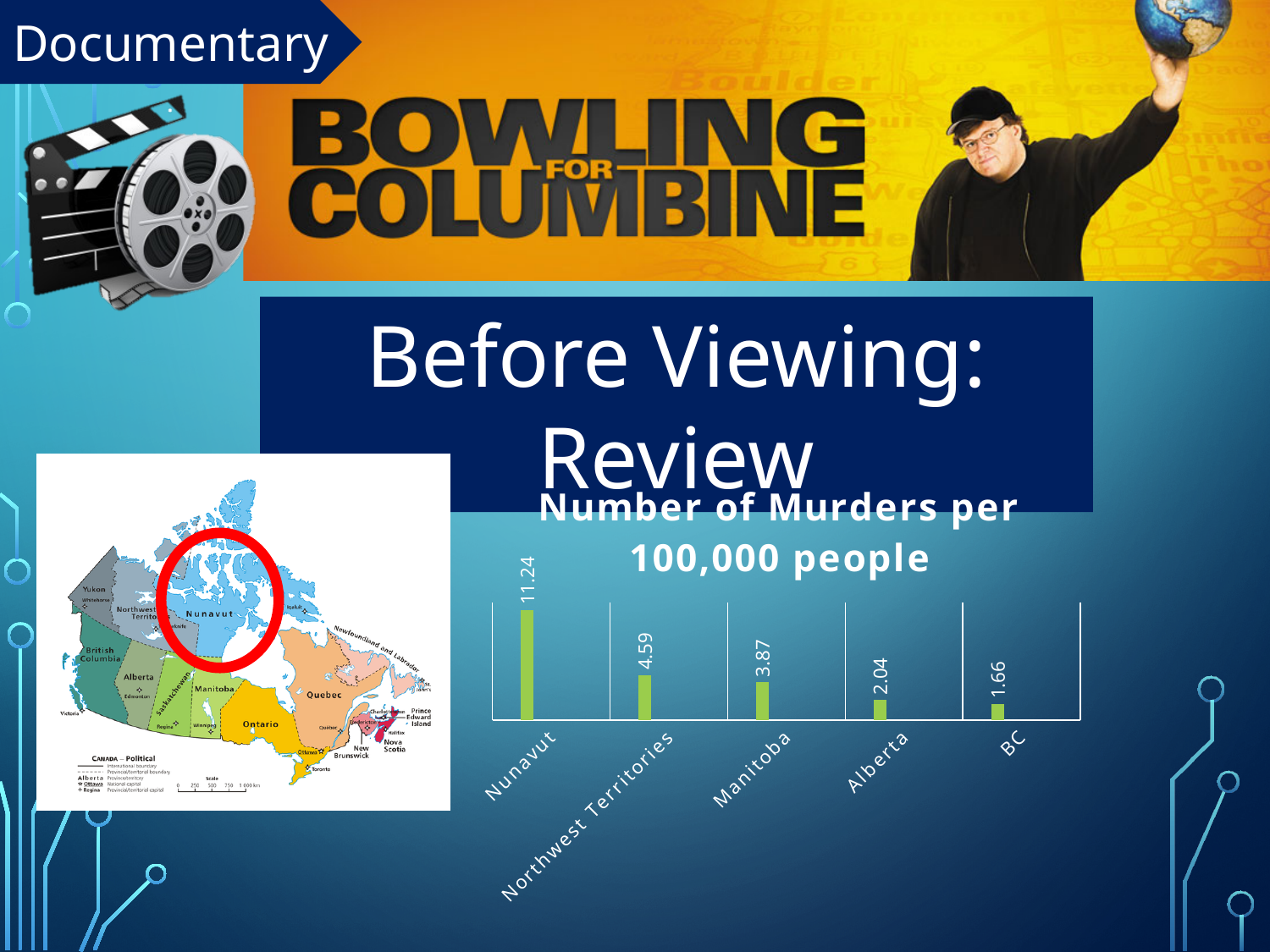
Which has a higher value, Manitoba or Alberta? Manitoba What kind of chart is shown on the slide? Bar chart What is the number of murders per 100,000 people for Alberta? 2.04 How many categories are shown in the chart? 5 What is the difference between the values for Alberta and BC? 0.38 Which category has the highest number of murders per 100,000 people? Nunavut What is the number of murders per 100,000 people for Nunavut? 11.24 What is the number of murders per 100,000 people for Northwest Territories? 4.59 What is the number of murders per 100,000 people for Manitoba? 3.87 What is the difference between the values for Nunavut and Northwest Territories? 6.65 Which category has the lowest number of murders per 100,000 people? BC What is the number of murders per 100,000 people for BC? 1.66